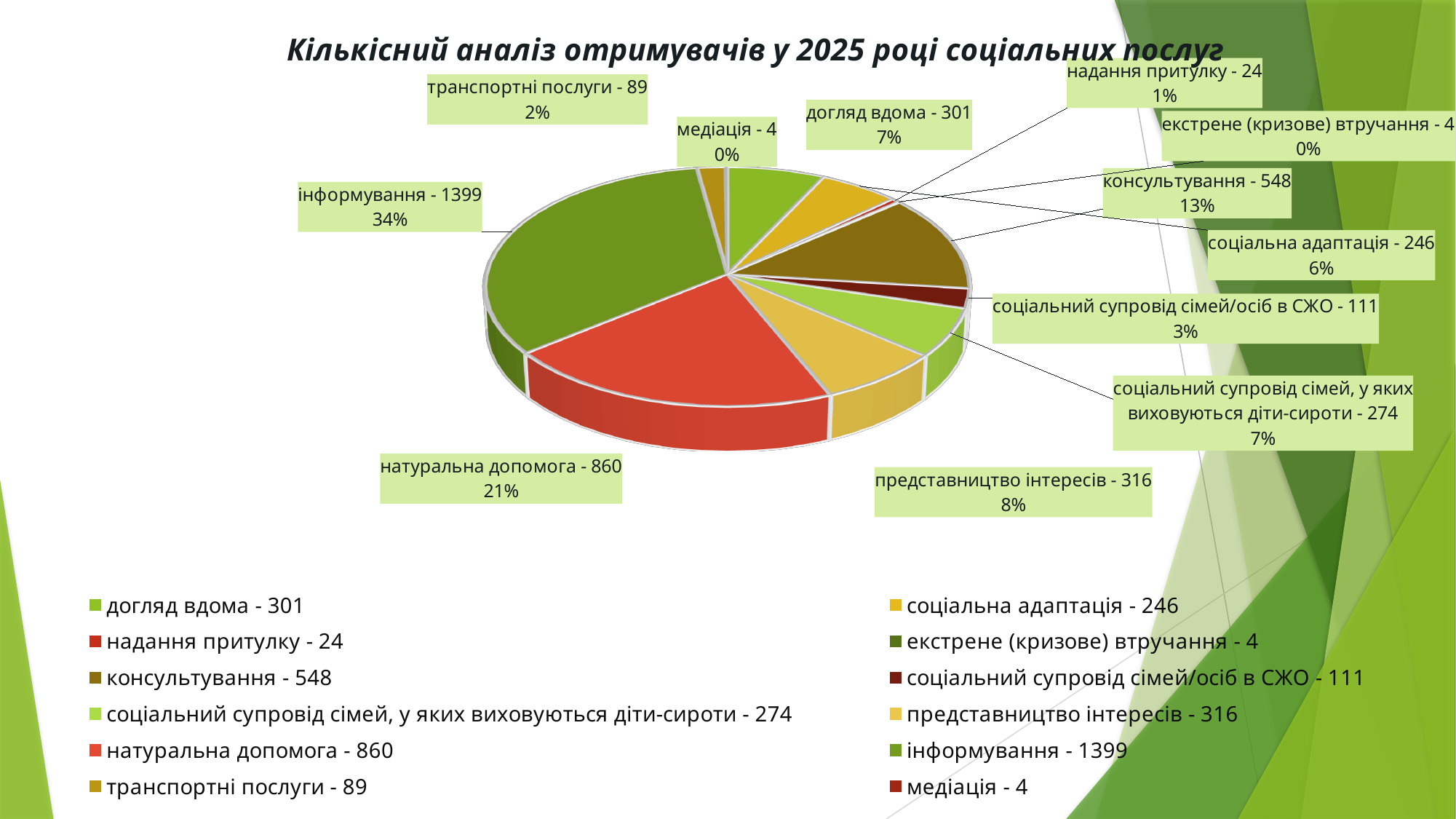
Which is larger, the value for консультування or the value for догляд вдома? консультування What is the value for соціальний супровід сімей/осіб в СЖО? 111 How many categories does the pie chart have? 12 What is the title of the chart? Кількісний аналіз отримувачів у 2025 році соціальних послуг What is the value for консультування? 548 What is the difference between the values for інформування and натуральна допомога? 539 What kind of chart is shown on the slide? pie chart What share of the pie does інформування represent? 34% What is the value for натуральна допомога? 860 What is the value for інформування? 1399 Which category has the highest value? інформування What share of the pie does представництво інтересів represent? 8%